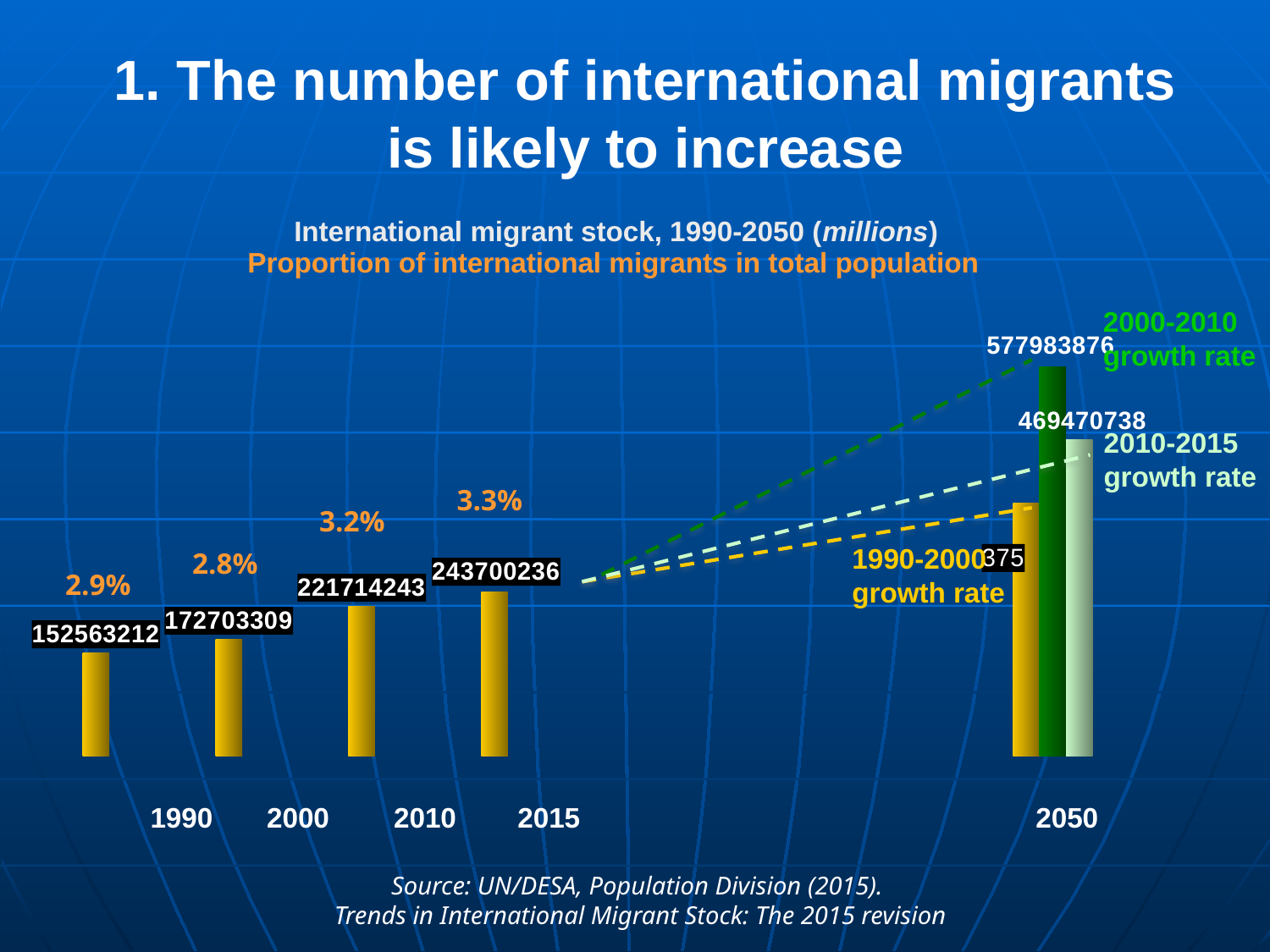
What proportion of the total population did international migrants make up in 2015? 3.3% What is the international migrant stock value shown for 2010? 221714243 Which year has the lowest international migrant stock shown on the chart? 1990 What is the international migrant stock value shown for 2015? 243700236 What is the international migrant stock value shown for 2000? 172703309 What is the difference between the migrant stock in 2015 and in 2010? 21985993 What kind of chart is shown on the slide? Bar chart What proportion of the total population did international migrants make up in 2000? 2.8% What is the 2050 projected migrant stock based on the 2010-2015 growth rate? 469470738 What is the 2050 projected migrant stock based on the 2000-2010 growth rate? 577983876 Which 2050 projection is larger: the one based on the 2000-2010 growth rate or the one based on the 2010-2015 growth rate? 2000-2010 growth rate What is the international migrant stock value shown for 1990? 152563212